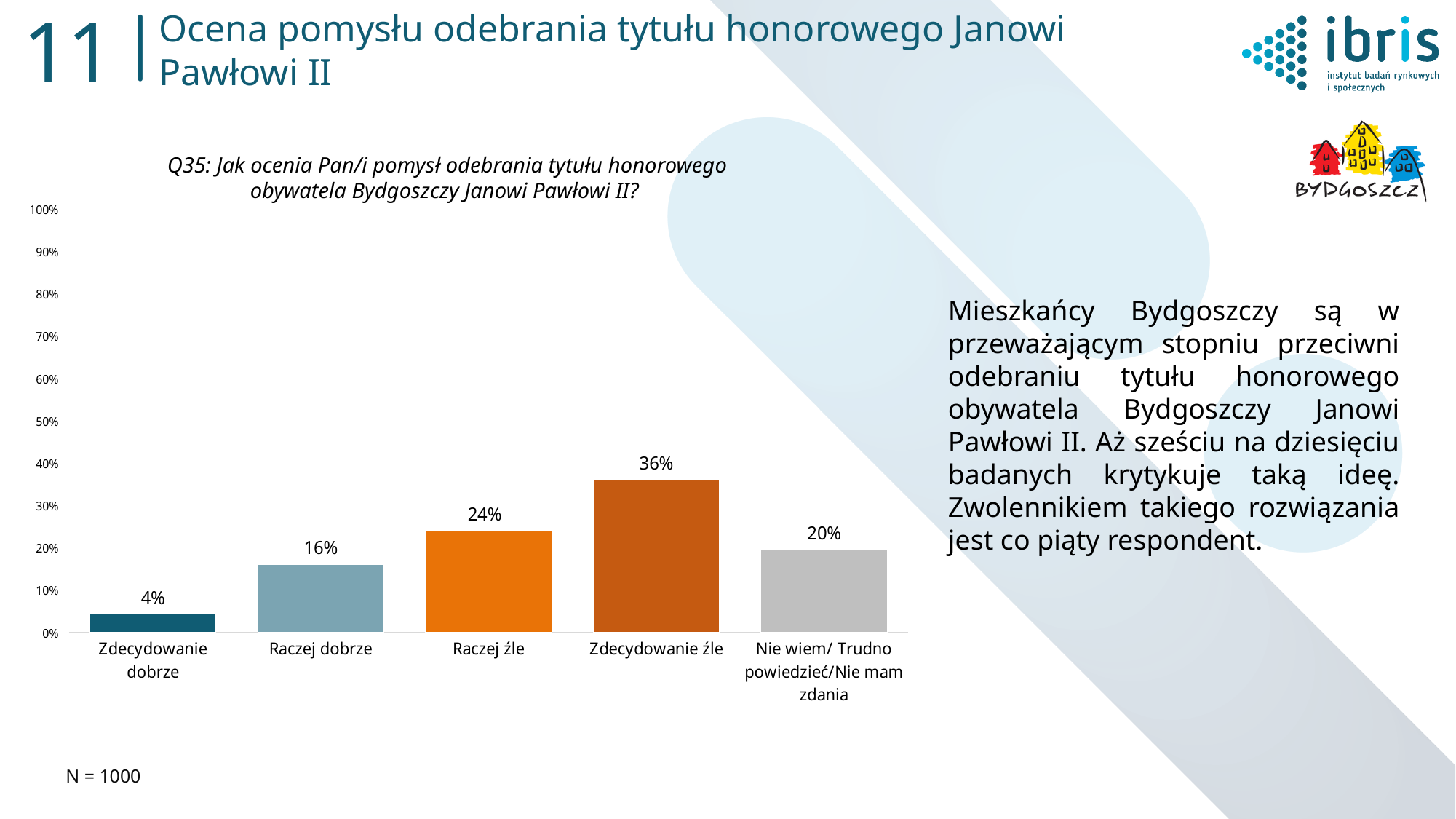
What is the value for "Zdecydowanie źle"? 36% Which category has the highest value? Zdecydowanie źle What kind of chart is shown on the slide? Bar chart What is the value for "Raczej źle"? 24% Which category has the lowest value? Zdecydowanie dobrze What is the sample size (N) stated below the chart? N = 1000 How many categories are shown on the chart? 5 What is the value for "Zdecydowanie dobrze"? 4% What is the difference between the values for "Zdecydowanie źle" and "Raczej dobrze"? 20% What is the value for "Raczej dobrze"? 16% Which is larger, the value for "Raczej źle" or the value for "Nie wiem/ Trudno powiedzieć/Nie mam zdania"? Raczej źle What is the value for "Nie wiem/ Trudno powiedzieć/Nie mam zdania"? 20%